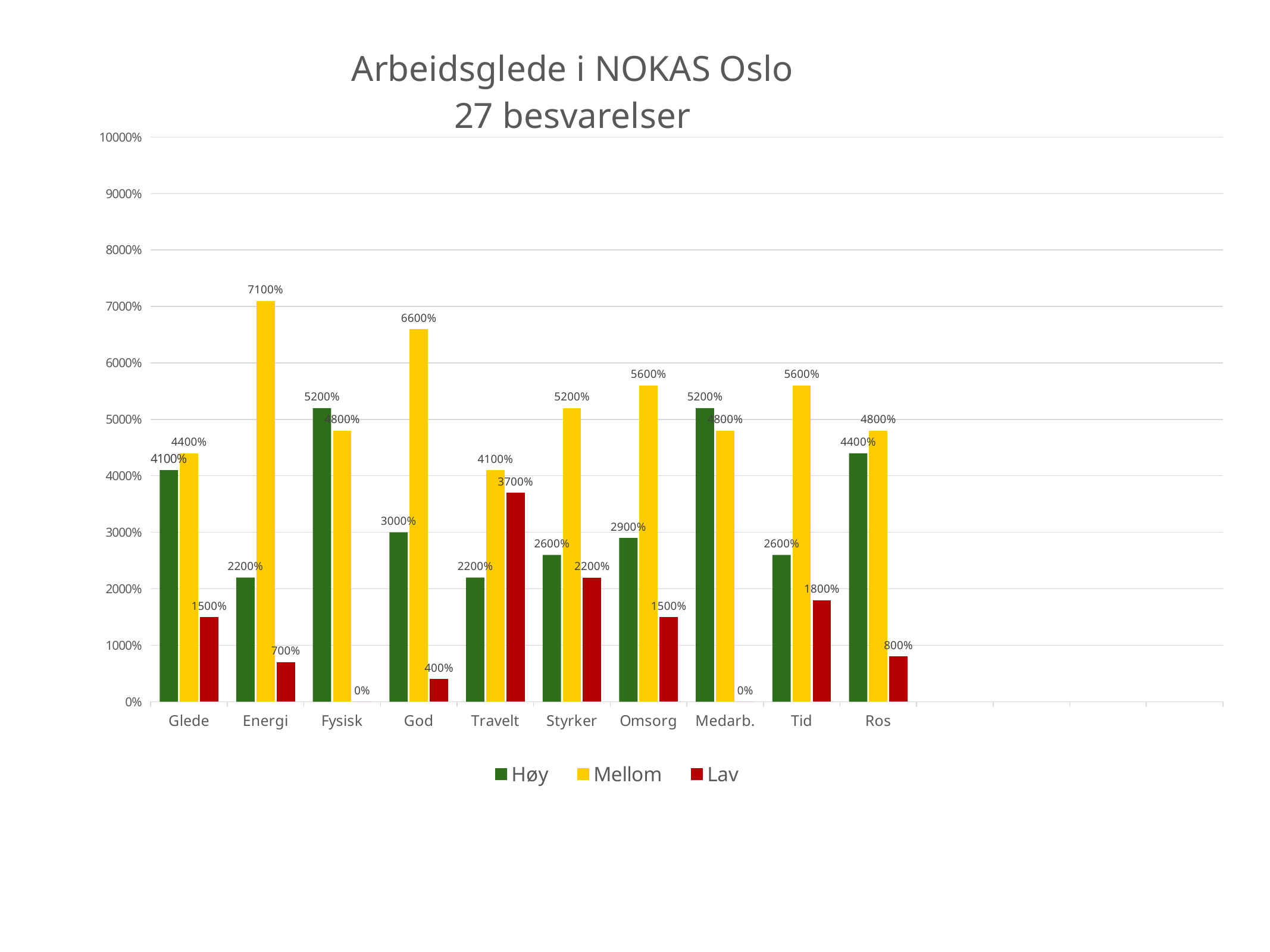
What is the title of the chart? Arbeidsglede i NOKAS Oslo 27 besvarelser How many series does the legend list? 3 What is the difference between the Mellom and Høy values for God? 3600% How many categories are shown on the x axis? 10 Which category has the lowest Høy value? Energi and Travelt (both 2200%) What is the Lav value for Travelt? 3700% Which is larger for Fysisk, the Høy value or the Mellom value? Høy Which category has the highest Lav value? Travelt What kind of chart is shown on the slide? Bar chart What is the Mellom value for Energi? 7100% What is the Høy value for Omsorg? 2900% Which category has the highest Mellom value? Energi